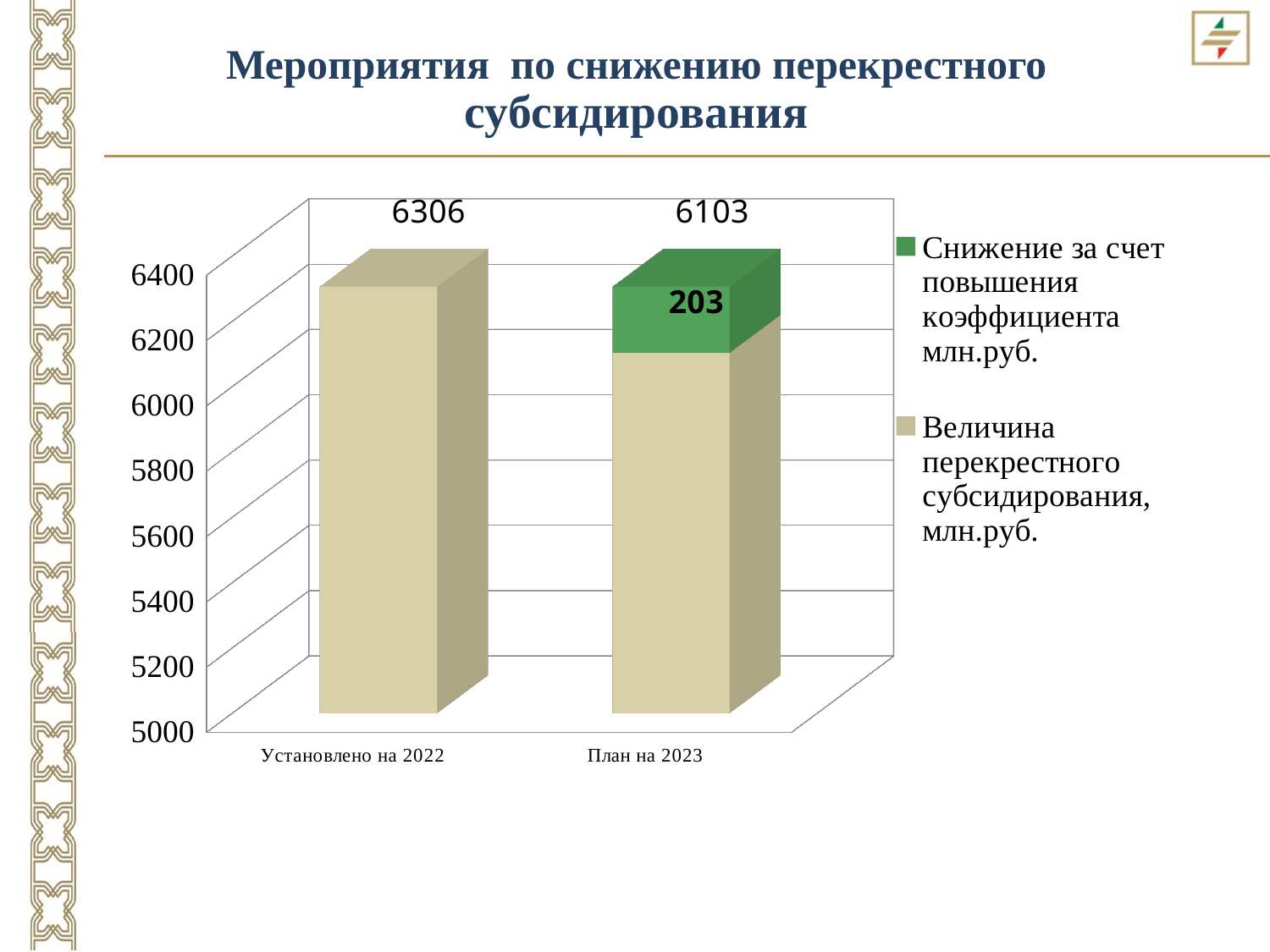
By how much is the "Величина перекрестного субсидирования" value for "Установлено на 2022" larger than for "План на 2023"? 203 What kind of chart is shown on the slide? Bar chart What is the value of "Величина перекрестного субсидирования, млн.руб." for "Установлено на 2022"? 6306 Which category has the larger "Величина перекрестного субсидирования" value: "Установлено на 2022" or "План на 2023"? Установлено на 2022 Does the "Величина перекрестного субсидирования" value rise or fall from "Установлено на 2022" to "План на 2023"? Fall What is the title of the slide containing the chart? Мероприятия по снижению перекрестного субсидирования What is the value of "Снижение за счет повышения коэффициента млн.руб." for "План на 2023"? 203 What is the value of "Величина перекрестного субсидирования, млн.руб." for "План на 2023"? 6103 How many series does the chart legend list? 2 How many categories are shown on the x axis of the chart? 2 What colour represents the series "Снижение за счет повышения коэффициента млн.руб." in the chart? Green What is the total of the stacked bar for "План на 2023"? 6306